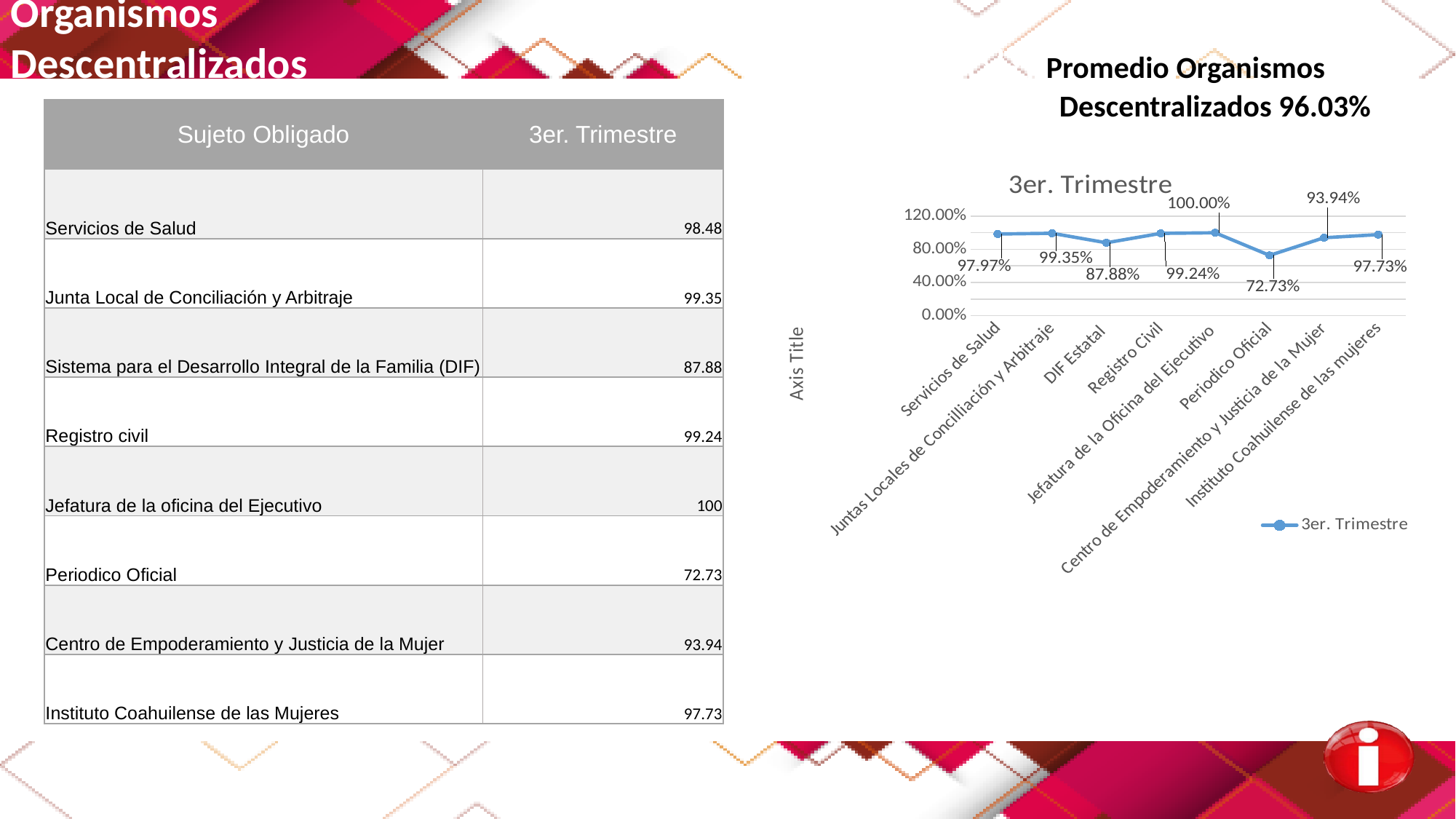
What kind of chart is shown on the slide? line chart Which category has the highest value in the chart? Jefatura de la Oficina del Ejecutivo What is the value for Periodico Oficial in the chart? 72.73% What is the value for DIF Estatal in the chart? 87.88% How many series does the chart legend list? 1 Which category has the lowest value in the chart? Periodico Oficial What is the value for Jefatura de la Oficina del Ejecutivo in the chart? 100.00% What is the difference between the values for Registro Civil and Periodico Oficial in the chart? 26.51% What is the title of the chart? 3er. Trimestre Which is larger in the chart, the value for Centro de Empoderamiento y Justicia de la Mujer or the value for Instituto Coahuilense de las mujeres? Instituto Coahuilense de las mujeres Is the value for Periodico Oficial in the chart greater or less than 80.00%? less How many categories are plotted on the x axis of the chart? 8